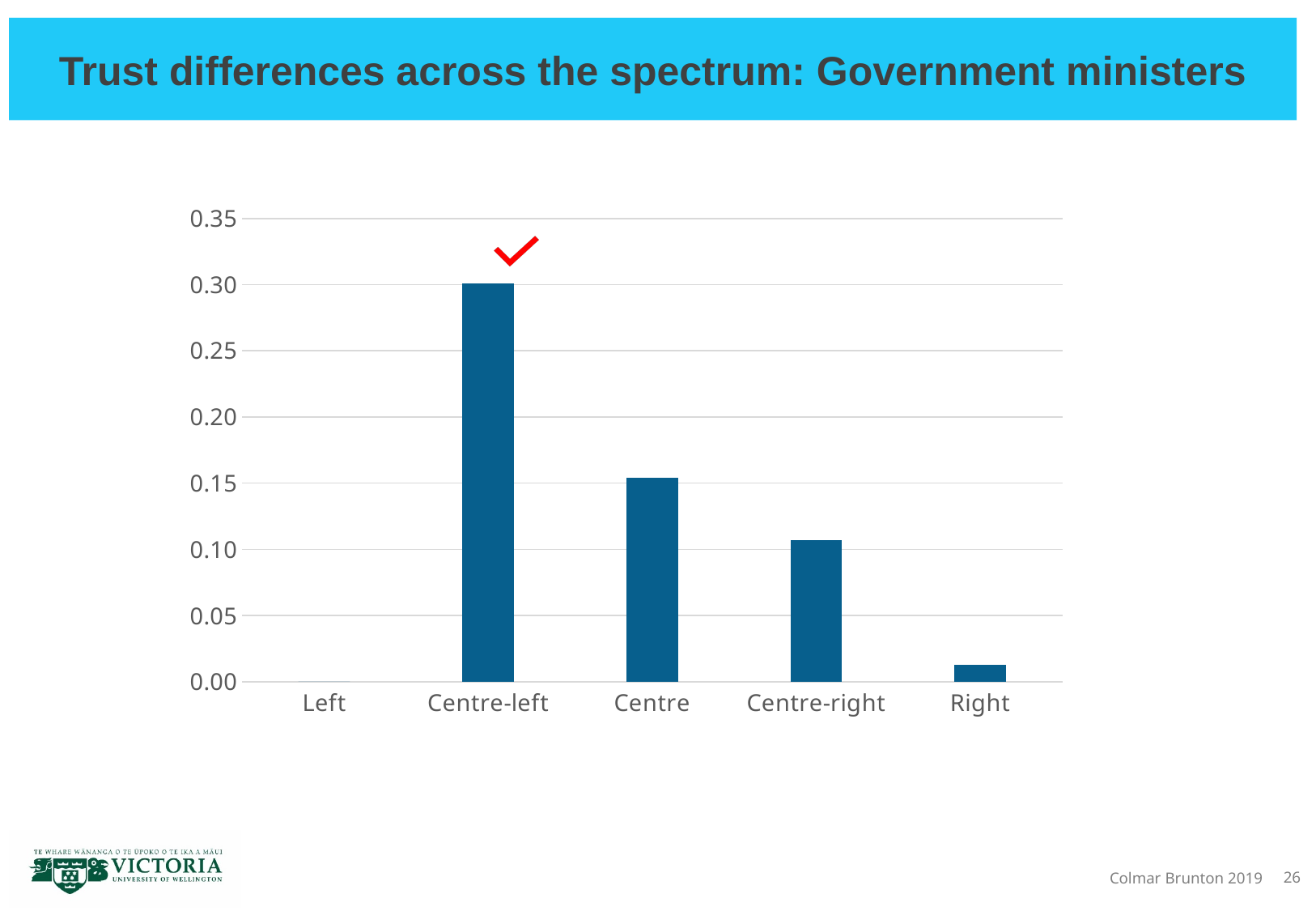
Is the value for Centre-left greater or less than 0.25? greater Is the value for Right greater or less than 0.05? less Is the value for Centre greater or less than 0.20? less Above which category's bar is a red check mark placed? Centre-left Which has the larger value, Centre-right or Right? Centre-right Which has the larger value, Centre or Centre-right? Centre Which category has the highest value in the chart? Centre-left What kind of chart is shown on the slide? bar chart Do the values rise or fall moving from Centre-left to Right along the x axis? fall Which category has the lowest value in the chart? Left How many categories are shown on the x axis of the chart? 5